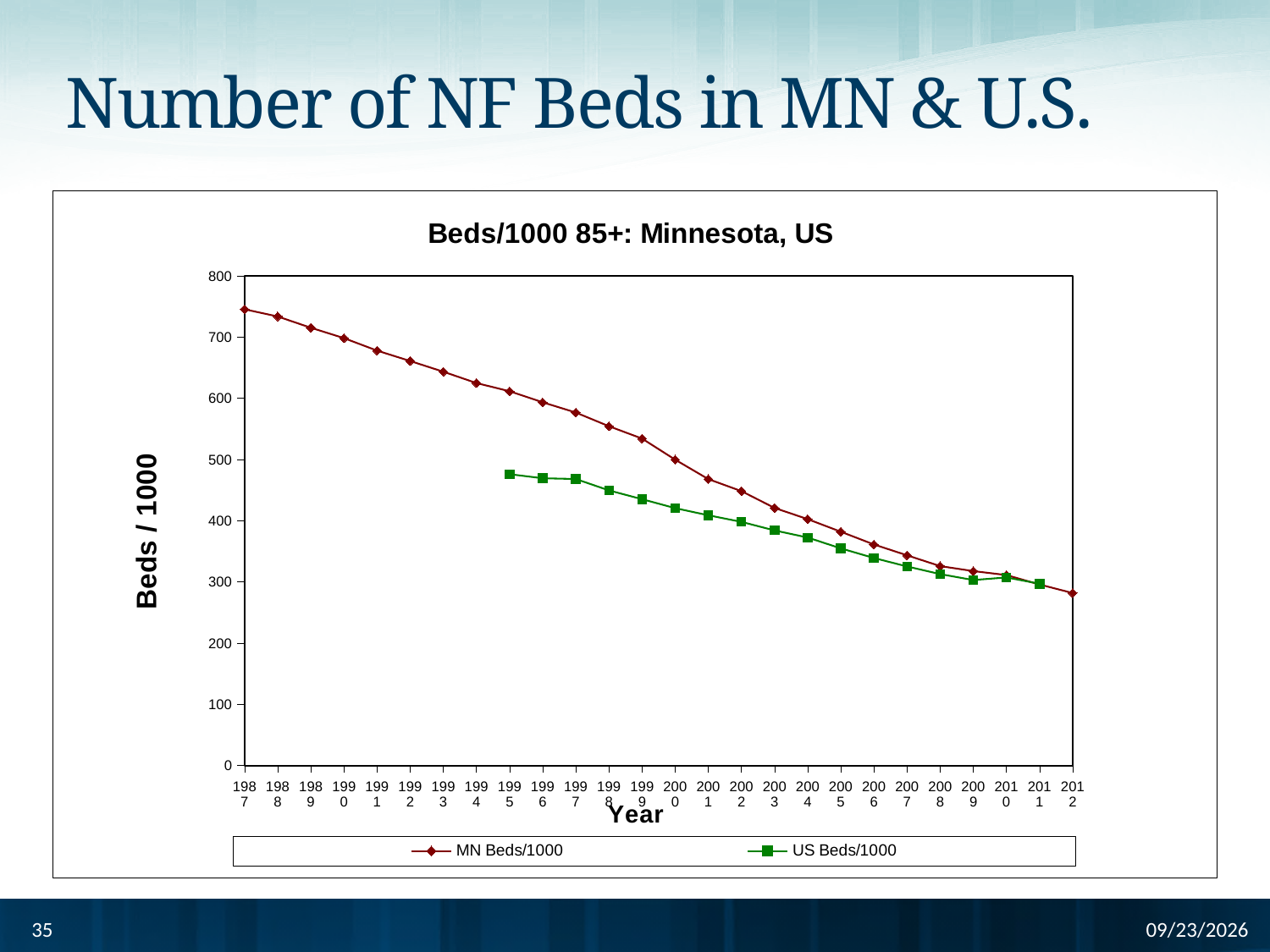
Do the MN Beds/1000 values rise or fall from 1987 to 2012? fall What is the label on the y axis? Beds / 1000 Is the US Beds/1000 value for 1995 greater or less than 500? less Is the MN Beds/1000 value for 2012 greater or less than 300? less Is the US Beds/1000 value for 2005 greater or less than 400? less What kind of chart is shown on the slide? line chart In which year is the MN Beds/1000 value highest? 1987 In 1995, which series has the higher value, MN Beds/1000 or US Beds/1000? MN Beds/1000 What is the title of the chart? Beds/1000 85+: Minnesota, US How many series does the legend list? 2